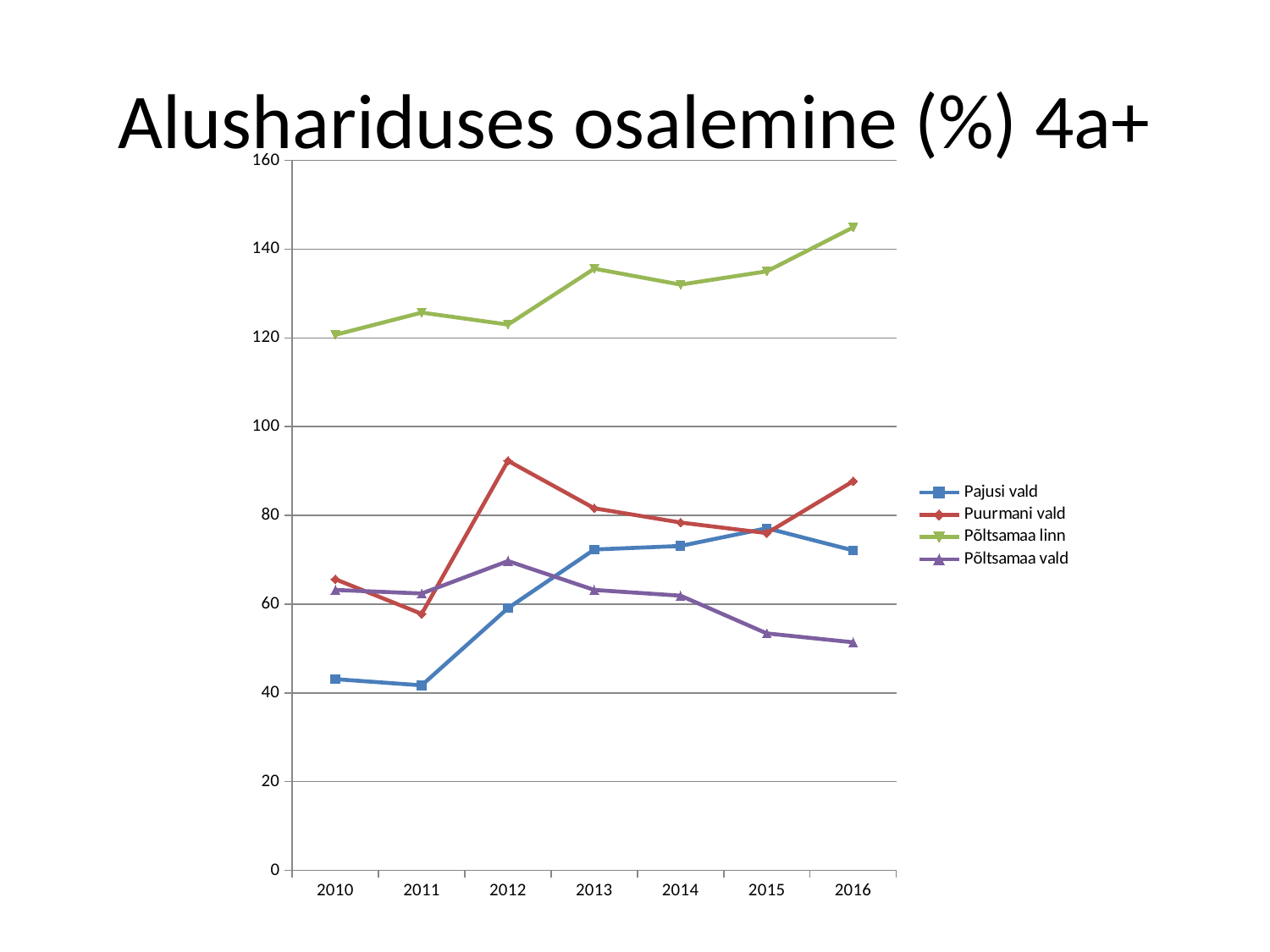
Is the value for Põltsamaa linn in 2016 greater or less than 140? greater In 2013, which is larger: the value for Puurmani vald or the value for Pajusi vald? Puurmani vald Is the value for Puurmani vald in 2012 greater or less than 80? greater How many years are shown on the x axis? 7 Which series has the lowest value in 2016? Põltsamaa vald What kind of chart is shown on the slide? line chart Is the value for Põltsamaa vald in 2016 greater or less than 60? less Which series has the highest value in 2016? Põltsamaa linn Does the Põltsamaa linn line rise or fall overall from 2010 to 2016? rise What is the title of the chart? Alushariduses osalemine (%) 4a+ How many series does the legend list? 4